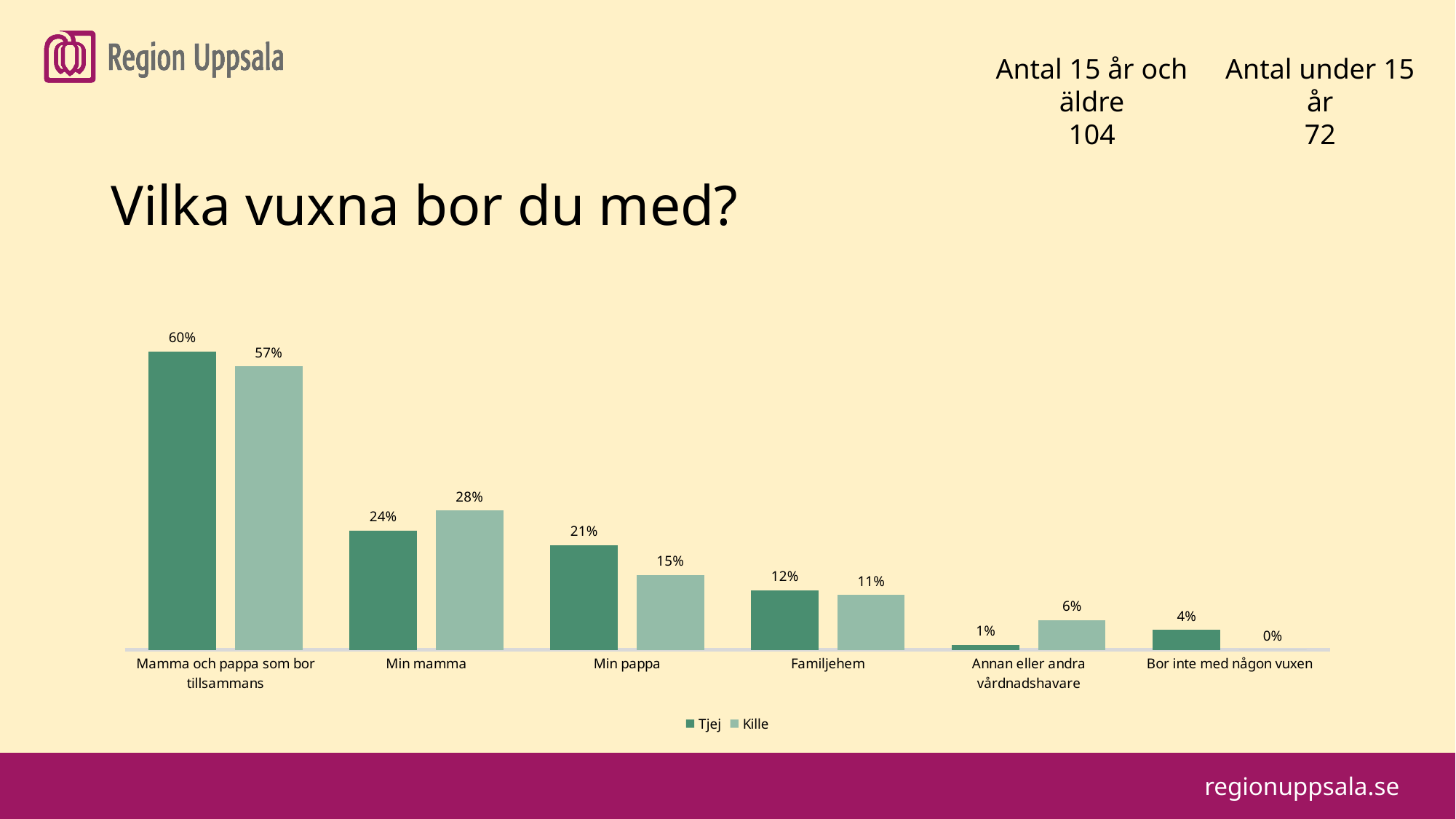
Which category has the lowest value for Tjej? Annan eller andra vårdnadshavare What is the value for Tjej in the category "Min pappa"? 21% What is the value for Kille in the category "Bor inte med någon vuxen"? 0% What is the value for Tjej in the category "Mamma och pappa som bor tillsammans"? 60% What is the value for Kille in the category "Min mamma"? 28% Which is larger for "Min mamma": the Tjej value or the Kille value? Kille Which category has the highest value for Kille? Mamma och pappa som bor tillsammans How many series does the legend list? 2 What are the two series named in the legend? Tjej and Kille What is the difference between the Tjej and Kille values for "Min pappa"? 6% How many categories are shown on the x axis? 6 What kind of chart is shown on the slide? Bar chart